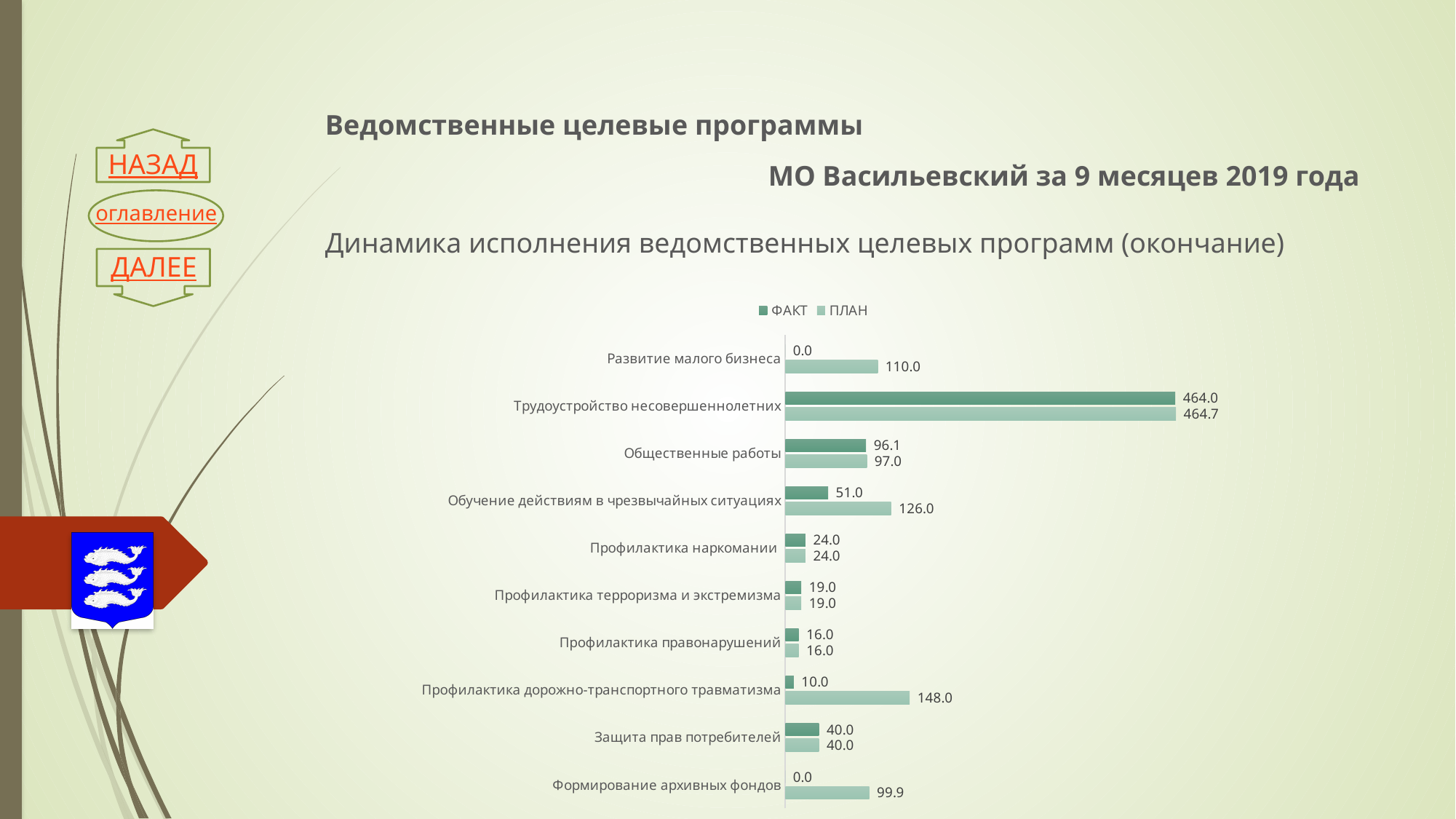
What kind of chart is shown on the slide? Bar chart How many categories are shown in the chart? 10 What is the ПЛАН value for Профилактика дорожно-транспортного травматизма? 148.0 What is the difference between the ПЛАН and ФАКТ values for Общественные работы? 0.9 What is the difference between the ПЛАН and ФАКТ values for Обучение действиям в чрезвычайных ситуациях? 75.0 What is the ПЛАН value for Формирование архивных фондов? 99.9 Which category has the highest ПЛАН value? Трудоустройство несовершеннолетних How many series does the legend list? 2 Which is larger for Развитие малого бизнеса, the ФАКТ value or the ПЛАН value? ПЛАН What is the ФАКТ value for Трудоустройство несовершеннолетних? 464.0 Which category has the lowest ПЛАН value? Профилактика правонарушений What is the ФАКТ value for Обучение действиям в чрезвычайных ситуациях? 51.0